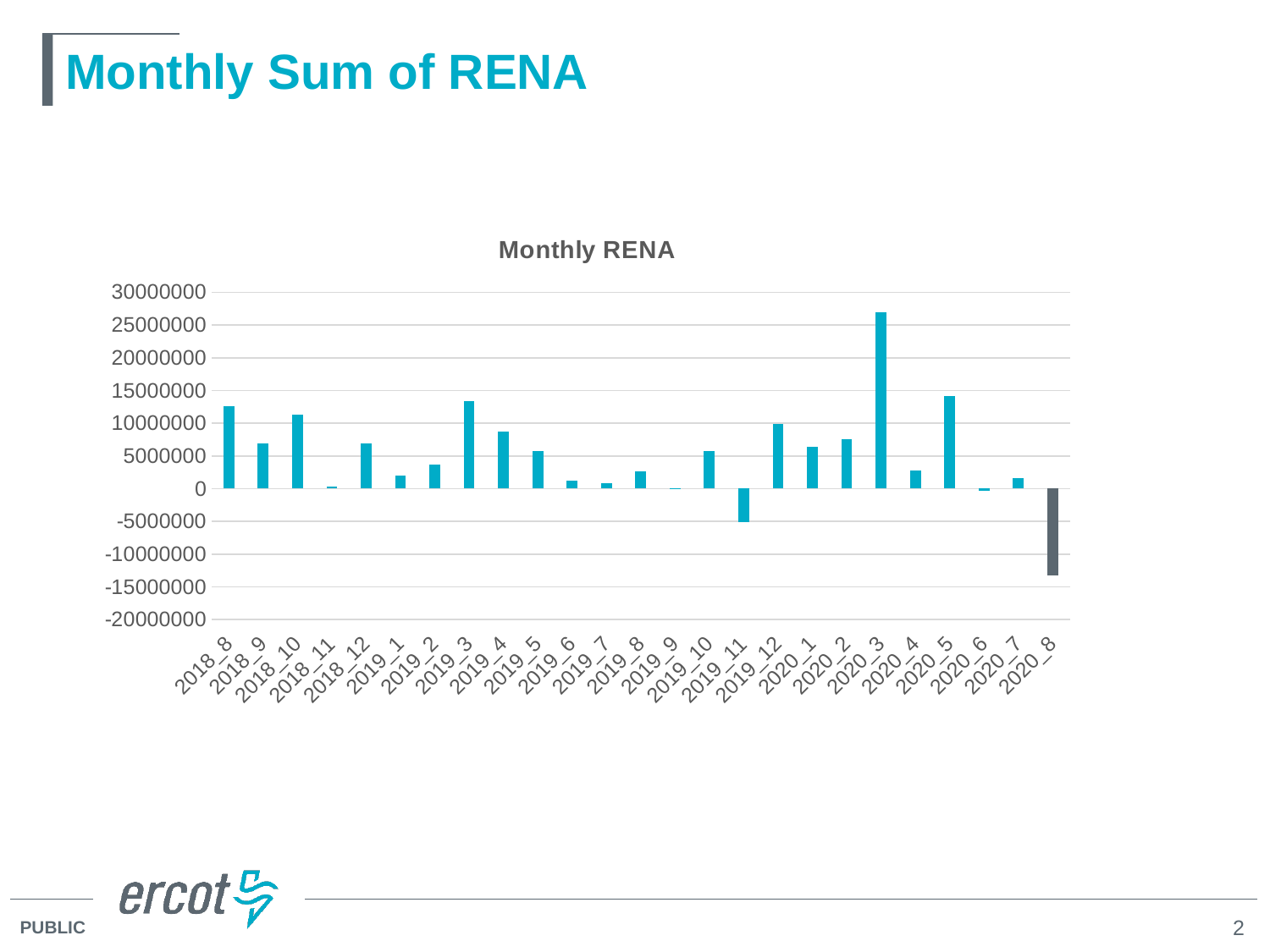
Is the Monthly RENA value for 2020_3 greater or less than 25000000? greater Is the Monthly RENA value for 2018_8 greater or less than 10000000? greater Is the Monthly RENA value for 2019_11 greater or less than 0? less What is the title of the chart on the slide? Monthly RENA Which month has the larger Monthly RENA value, 2020_5 or 2020_4? 2020_5 Which month has the larger Monthly RENA value, 2019_3 or 2019_5? 2019_3 Which month has the lowest Monthly RENA value? 2020_8 Which month has the highest Monthly RENA value? 2020_3 What kind of chart is shown on the slide? bar chart How many monthly categories are plotted on the x axis of the Monthly RENA chart? 25